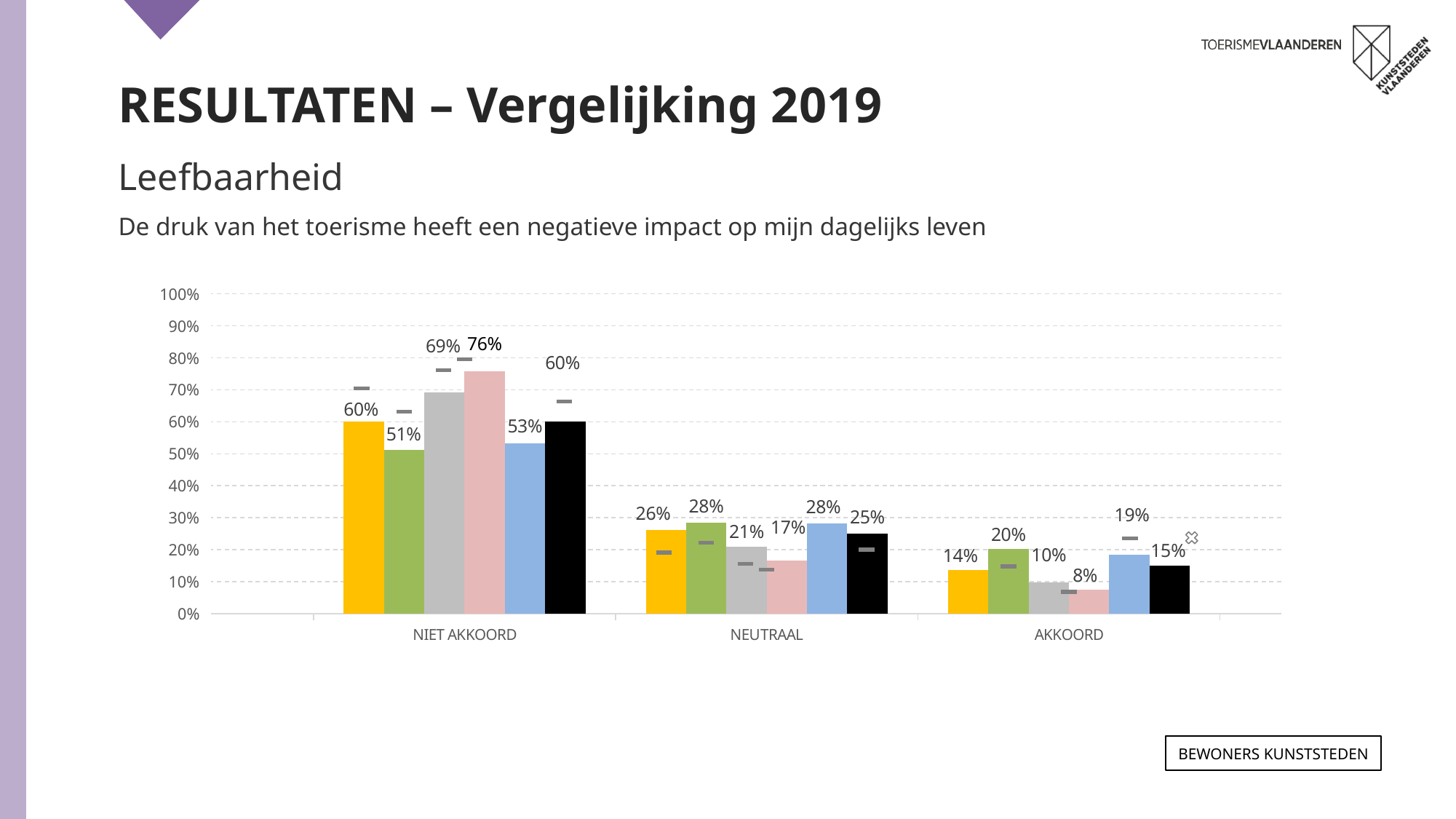
What is the value of the grey bar in the NEUTRAAL category? 21% How many bars are plotted in each category of the chart? 6 What is the value of the green bar in the AKKOORD category? 20% What type of chart is shown on the slide? bar chart What is the difference between the grey bar (69%) and the green bar (51%) in the NIET AKKOORD category? 18% Which bar is the highest in the NIET AKKOORD category? the pink bar (76%) What statement is the chart about, as written above it? De druk van het toerisme heeft een negatieve impact op mijn dagelijks leven Is the value of the black bar in the AKKOORD category greater or less than 20%? less What is the value of the pink bar in the NIET AKKOORD category? 76% How many categories are shown on the x axis of the chart? 3 Which bar is the lowest in the AKKOORD category? the pink bar (8%) In the NEUTRAAL category, which is larger: the yellow bar or the pink bar? the yellow bar (26%)